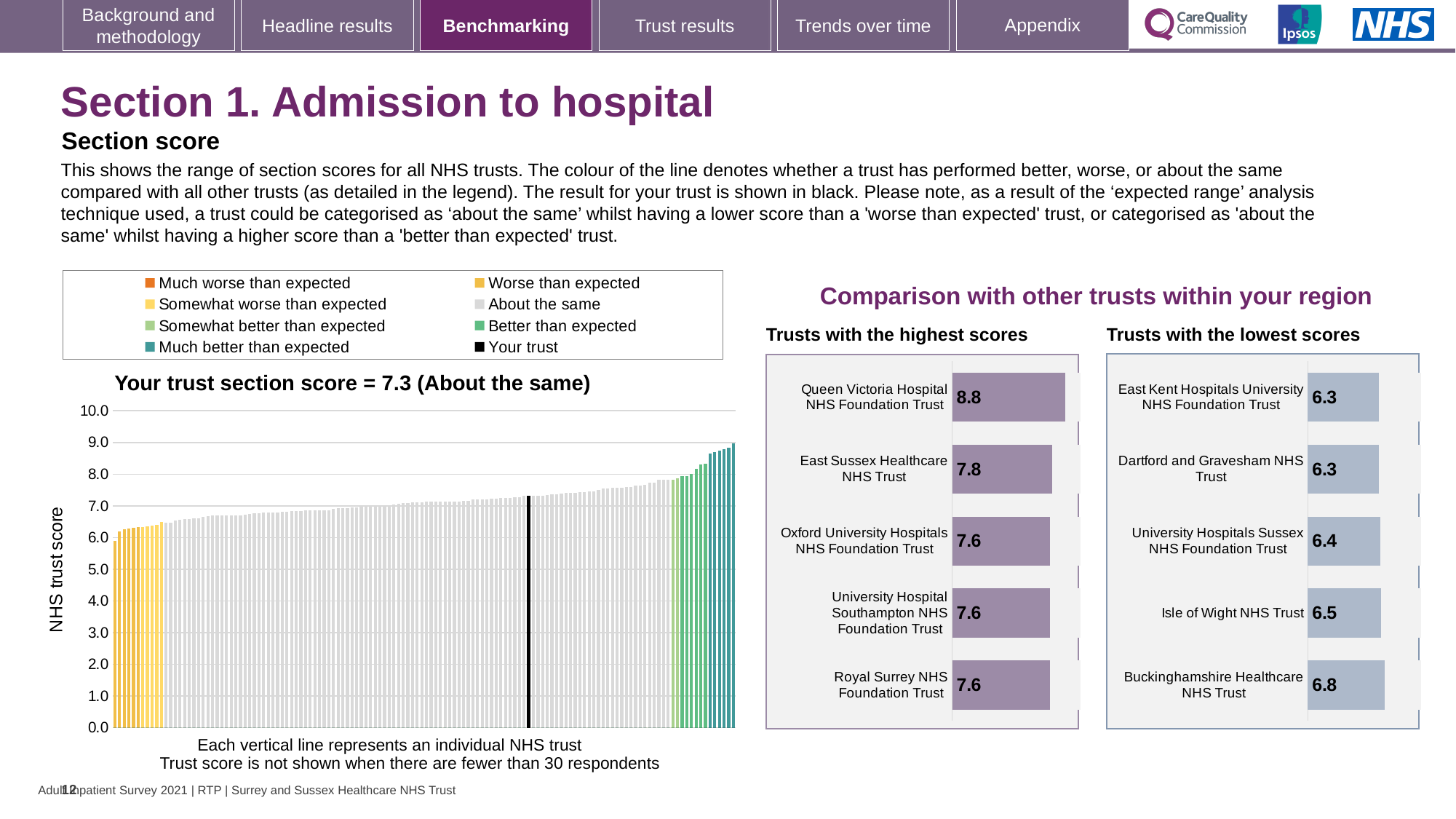
How many entries does the legend above the 'Your trust section score' chart list? 8 In the 'Your trust section score' chart, what is the highest value shown on the vertical axis? 10.0 In the 'Trusts with the lowest scores' chart, which trust has the highest score? Buckinghamshire Healthcare NHS Trust In the 'Trusts with the highest scores' chart, what is the difference between the scores of Queen Victoria Hospital NHS Foundation Trust and East Sussex Healthcare NHS Trust? 1.0 In the 'Trusts with the highest scores' chart, which trust has the highest score? Queen Victoria Hospital NHS Foundation Trust In the 'Your trust section score' chart, do the trust scores rise or fall from left to right? rise In the 'Trusts with the lowest scores' chart, what is the score for Isle of Wight NHS Trust? 6.5 In the 'Trusts with the highest scores' chart, what is the score for Queen Victoria Hospital NHS Foundation Trust? 8.8 In the 'Trusts with the lowest scores' chart, which has the larger score: Isle of Wight NHS Trust or University Hospitals Sussex NHS Foundation Trust? Isle of Wight NHS Trust What kind of chart is the 'Your trust section score' chart? bar chart In the 'Trusts with the highest scores' chart, how many trusts are shown? 5 In the 'Your trust section score' chart, what is the section score for your trust? 7.3